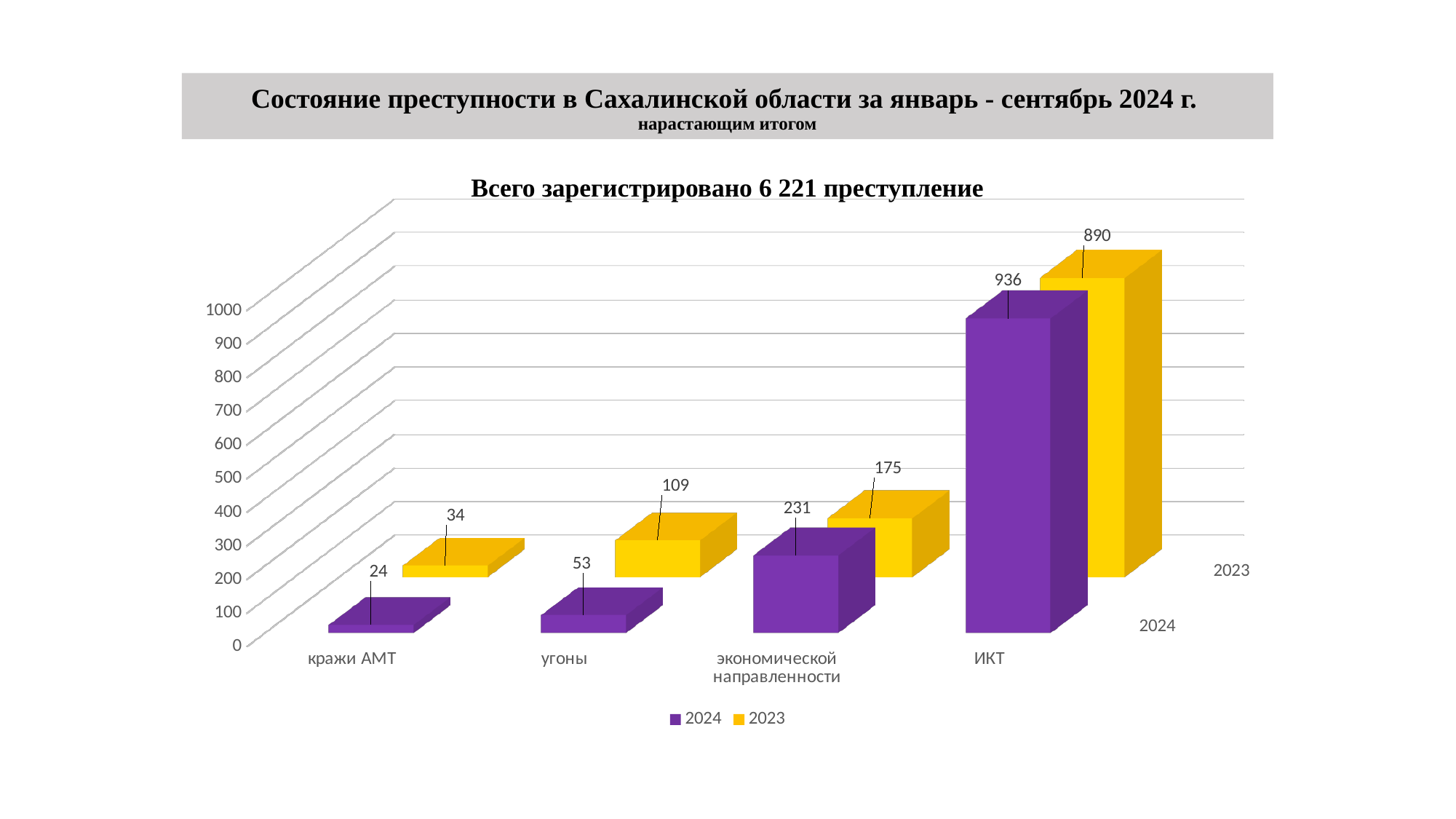
What is the value for экономической направленности in the 2023 series? 175 What is the chart's title? Всего зарегистрировано 6 221 преступление Which is larger for экономической направленности: the 2024 value or the 2023 value? 2024 Which category has the highest value in the 2023 series? ИКТ Which category has the lowest value in the 2024 series? кражи АМТ What is the difference between the 2024 and 2023 values for ИКТ? 46 What is the value for ИКТ in the 2024 series? 936 What is the value for кражи АМТ in the 2024 series? 24 What kind of chart is shown on the slide? bar chart How many series does the legend list? 2 How many categories are shown on the x axis? 4 What is the value for угоны in the 2023 series? 109